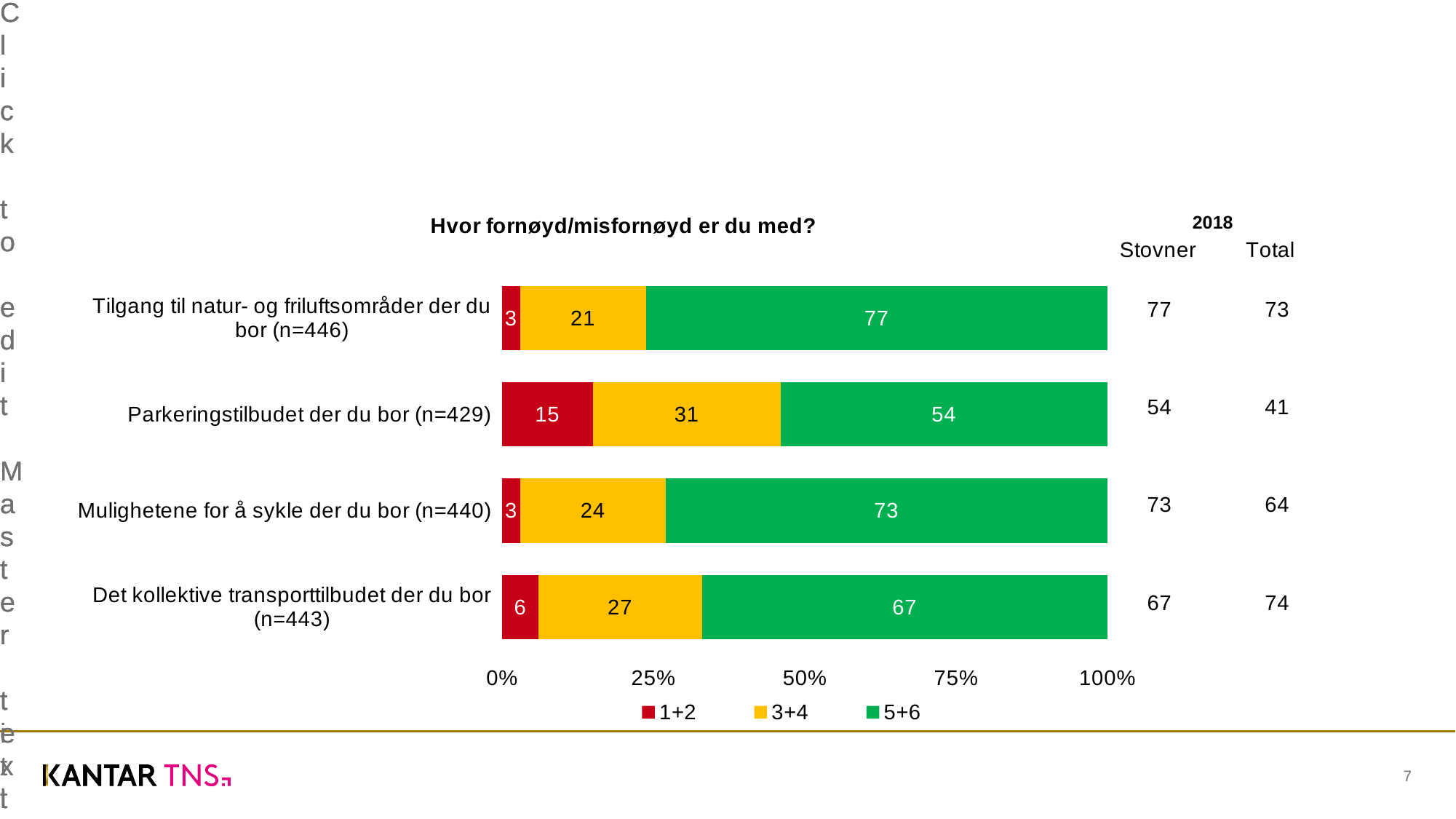
Which has the larger 3+4 value: "Parkeringstilbudet der du bor (n=429)" or "Det kollektive transporttilbudet der du bor (n=443)"? Parkeringstilbudet der du bor (n=429) Which category has the highest 5+6 value? Tilgang til natur- og friluftsområder der du bor (n=446) Which category has the lowest 5+6 value? Parkeringstilbudet der du bor (n=429) How many series does the legend list? 3 What is the value of the 5+6 segment for "Parkeringstilbudet der du bor (n=429)"? 54 What is the value of the 1+2 segment for "Det kollektive transporttilbudet der du bor (n=443)"? 6 Which category has the highest 1+2 value? Parkeringstilbudet der du bor (n=429) How many categories are shown in the chart? 4 What is the value of the 3+4 segment for "Mulighetene for å sykle der du bor (n=440)"? 24 What is the title of the chart? Hvor fornøyd/misfornøyd er du med? What kind of chart is shown on the slide? Stacked bar chart What is the difference between the 5+6 values for "Tilgang til natur- og friluftsområder der du bor (n=446)" and "Parkeringstilbudet der du bor (n=429)"? 23